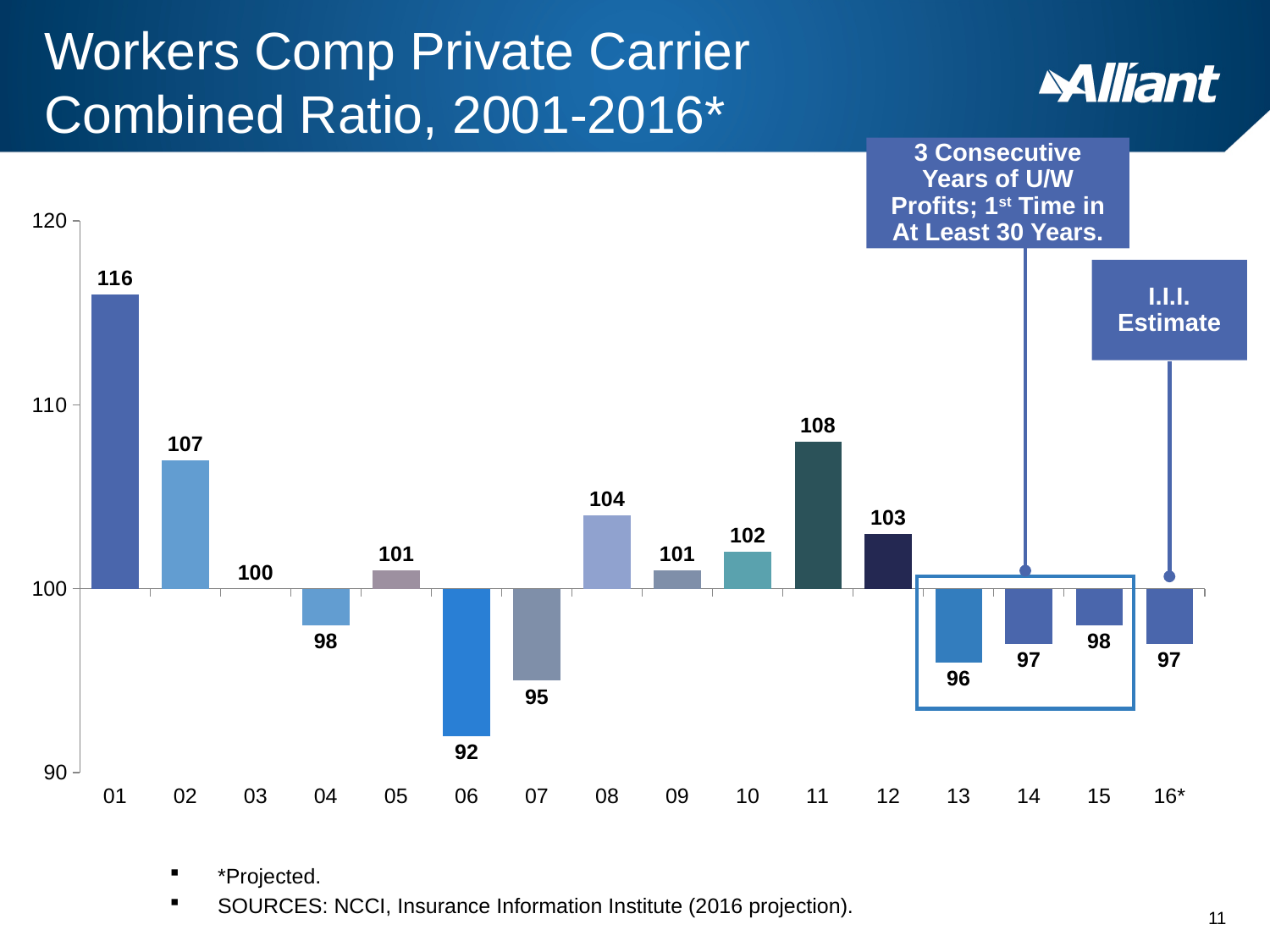
Which year has a higher combined ratio, 2008 or 2012? 2008 Do the combined ratios rise or fall from 2011 to 2013? Fall What is the combined ratio for 2001? 116 How many years are shown on the x axis? 16 What is the title of the chart? Workers Comp Private Carrier Combined Ratio, 2001-2016* What is the projected combined ratio for 2016? 97 Which year has the lowest combined ratio? 06 What is the combined ratio for 2006? 92 What kind of chart is shown on the slide? Bar chart What is the difference between the combined ratio in 2001 and in 2006? 24 What is the combined ratio for 2011? 108 Which year has the highest combined ratio? 01